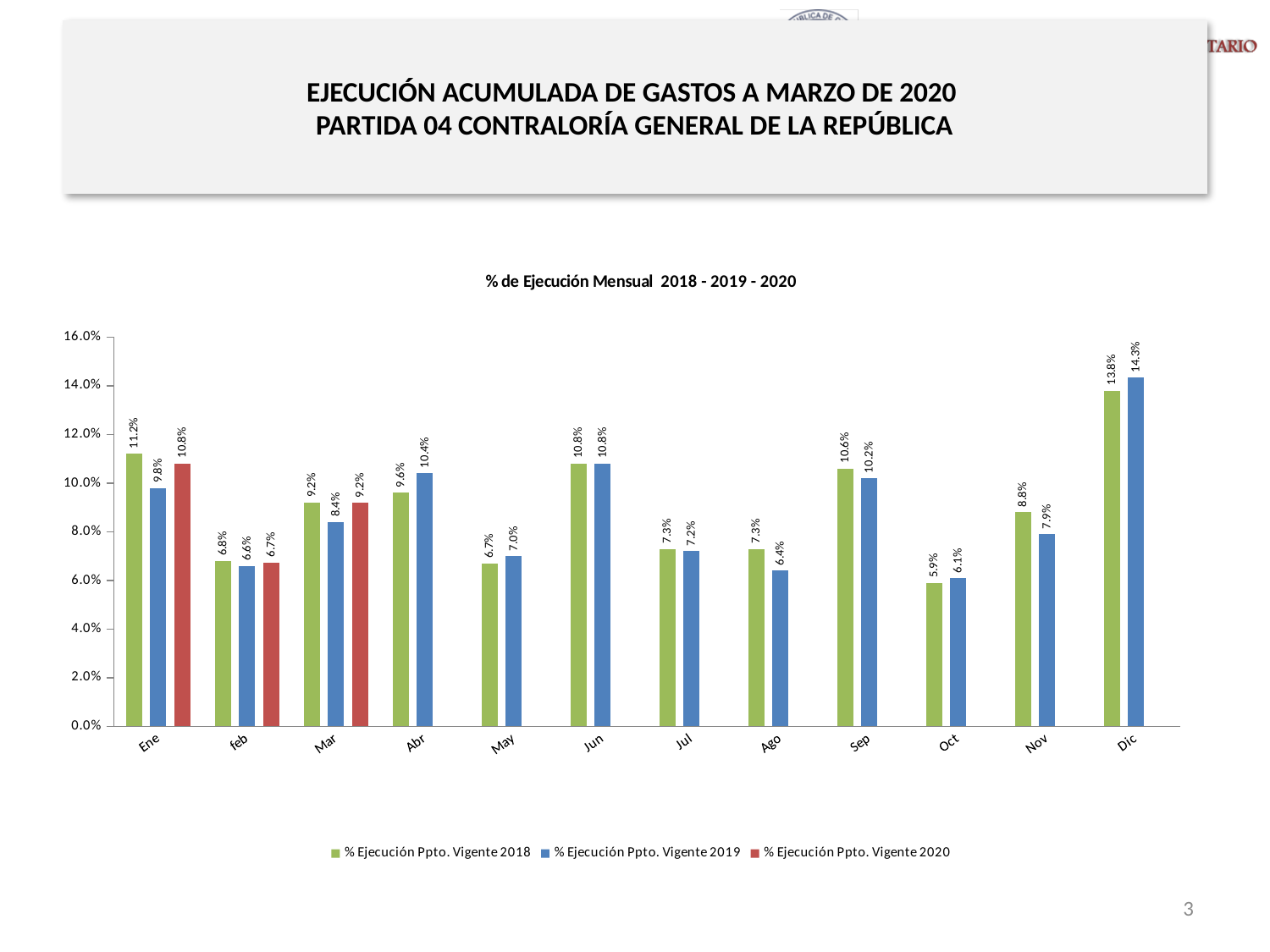
How many series does the legend list? 3 What is the difference between the 2019 and 2018 values in Dic? 0.5% What is the value for % Ejecución Ppto. Vigente 2019 in Abr? 10.4% What kind of chart is shown on the slide? Bar chart What is the difference between the 2018 and 2019 values in Ene? 1.4% Which month has the highest value for % Ejecución Ppto. Vigente 2019? Dic What is the value for % Ejecución Ppto. Vigente 2020 in Ene? 10.8% Which is larger in Ago: the 2018 value or the 2019 value? 2018 How many months are shown on the x axis? 12 What is the title of the chart? % de Ejecución Mensual 2018 - 2019 - 2020 What is the value for % Ejecución Ppto. Vigente 2018 in Sep? 10.6% Which month has the lowest value for % Ejecución Ppto. Vigente 2018? Oct